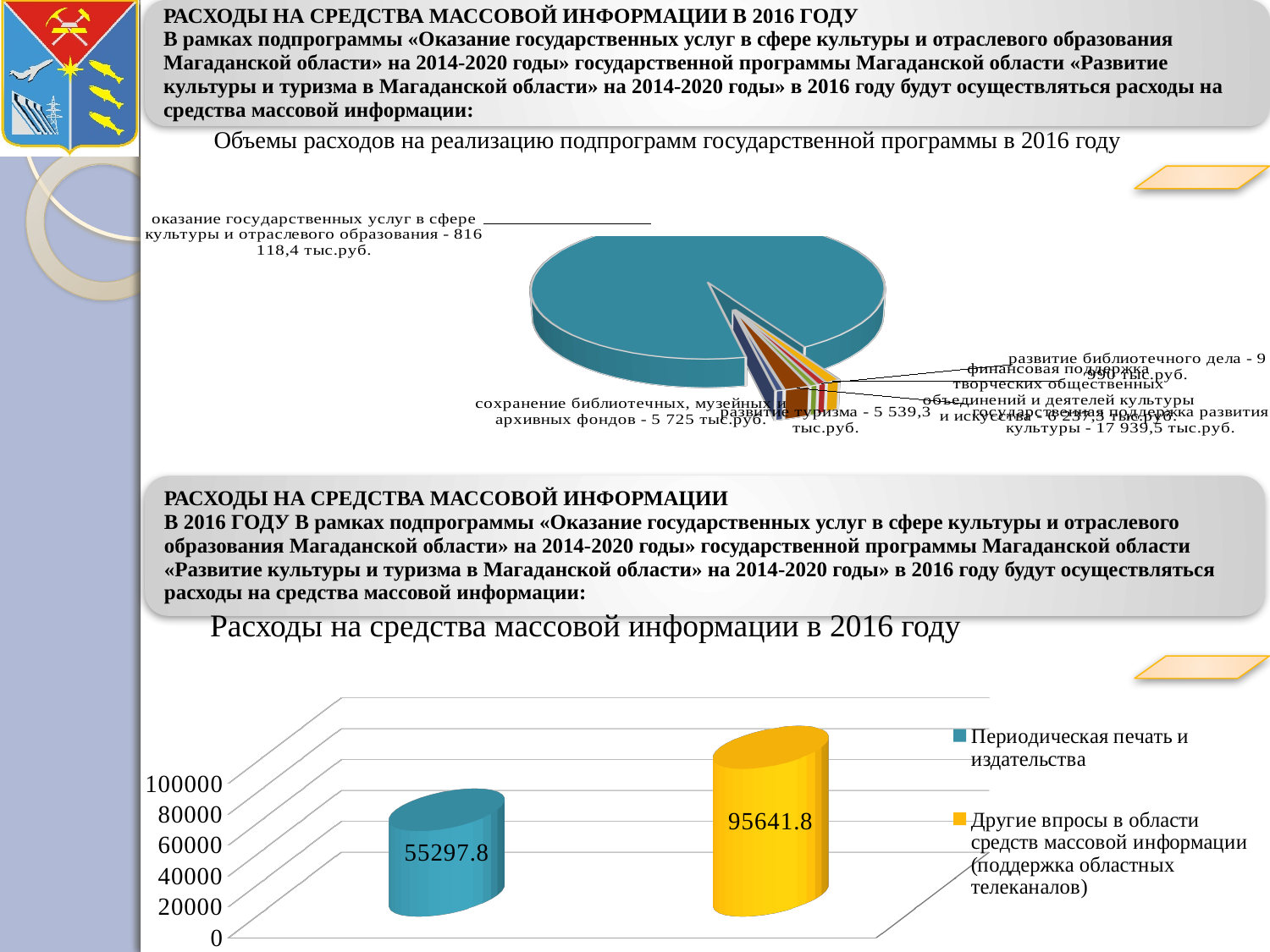
On the bar chart 'Расходы на средства массовой информации в 2016 году', what is the value for 'Другие впросы в области средств массовой информации (поддержка областных телеканалов)'? 95641.8 How many series does the legend of the bar chart 'Расходы на средства массовой информации в 2016 году' list? 2 On the pie chart 'Объемы расходов на реализацию подпрограмм государственной программы в 2016 году', which category has the largest slice? оказание государственных услуг в сфере культуры и отраслевого образования On the pie chart 'Объемы расходов на реализацию подпрограмм государственной программы в 2016 году', what is the value for 'развитие туризма'? 5 539,3 тыс.руб. What kind of chart is 'Объемы расходов на реализацию подпрограмм государственной программы в 2016 году'? pie chart What kind of chart is 'Расходы на средства массовой информации в 2016 году'? bar chart On the bar chart 'Расходы на средства массовой информации в 2016 году', what is the value for 'Периодическая печать и издательства'? 55297.8 On the bar chart 'Расходы на средства массовой информации в 2016 году', which series has the higher value? Другие впросы в области средств массовой информации (поддержка областных телеканалов) On the pie chart 'Объемы расходов на реализацию подпрограмм государственной программы в 2016 году', what is the value for 'оказание государственных услуг в сфере культуры и отраслевого образования'? 816 118,4 тыс.руб. On the pie chart 'Объемы расходов на реализацию подпрограмм государственной программы в 2016 году', what is the value for 'государственная поддержка развития культуры'? 17 939,5 тыс.руб. On the bar chart 'Расходы на средства массовой информации в 2016 году', is the value for 'Периодическая печать и издательства' greater or less than 60000? less On the bar chart 'Расходы на средства массовой информации в 2016 году', what is the difference between the two bars? 40344